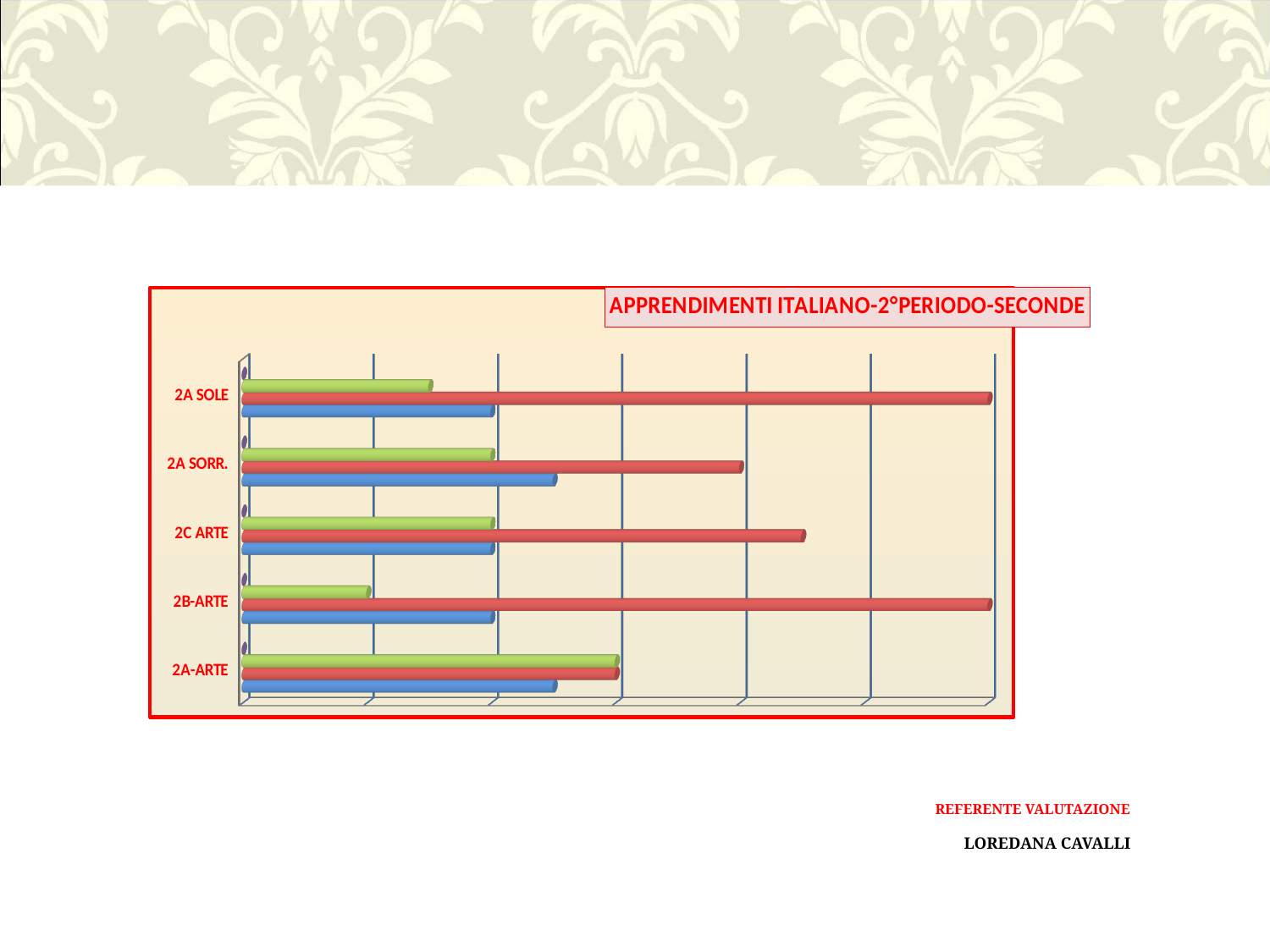
How many categories are shown on the vertical axis of the chart? 5 What is the title of the chart? APPRENDIMENTI ITALIANO-2°PERIODO-SECONDE Which category is listed at the top of the chart's vertical axis? 2A SOLE Which category has the longer red bar, 2A SORR. or 2C ARTE? 2C ARTE Which category has the longer green bar, 2A-ARTE or 2B-ARTE? 2A-ARTE Which category has the shortest red bar? 2A-ARTE Which category has the shortest green bar? 2B-ARTE What kind of chart is shown on the slide? bar chart Which category has the longest green bar? 2A-ARTE For 2A SOLE, which bar is longer, the blue bar or the green bar? blue bar How many bars are plotted for each category in the chart? 3